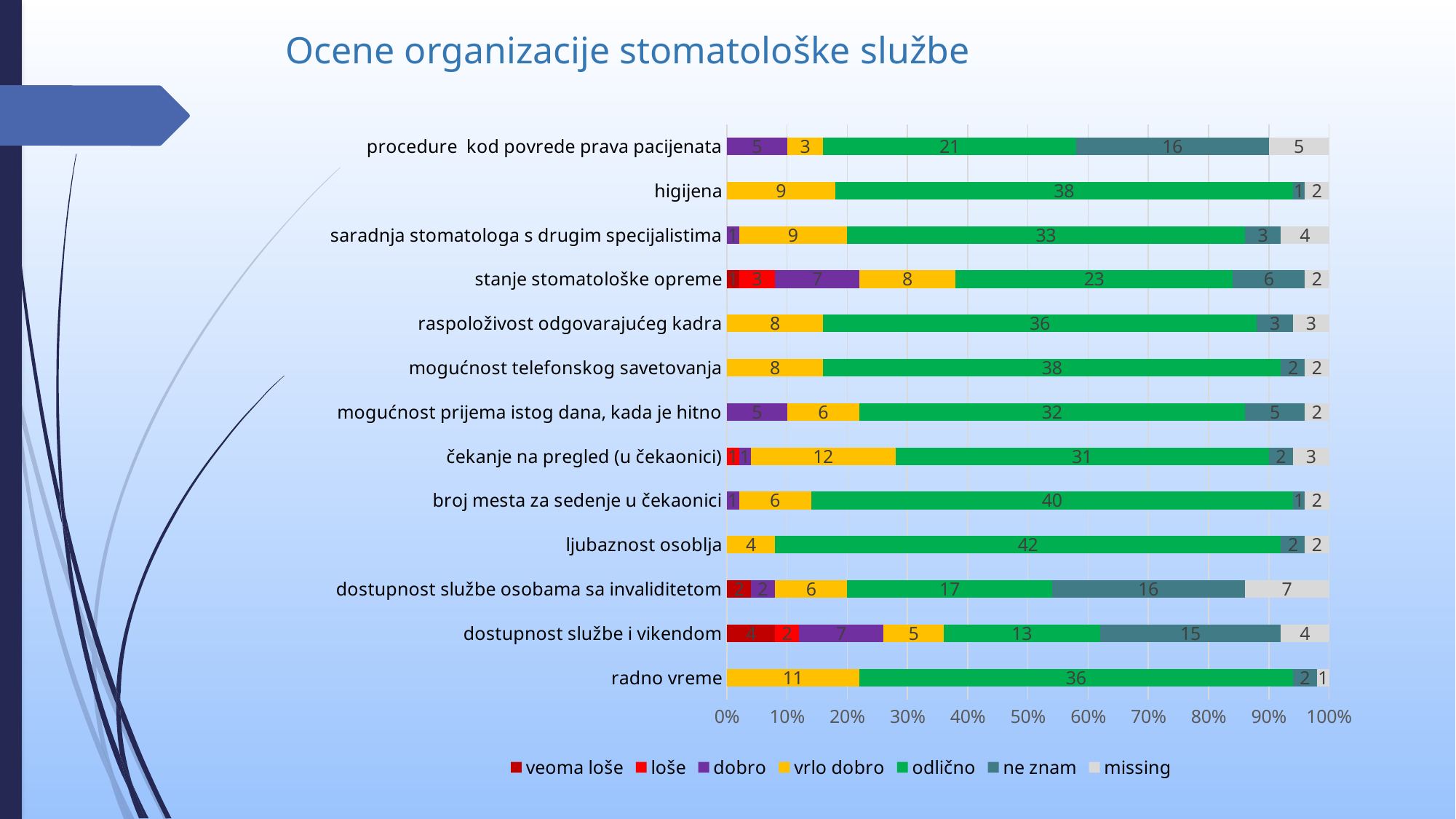
How many series does the legend list? 7 What is the 'ne znam' value for 'dostupnost službe osobama sa invaliditetom'? 16 How many categories are plotted on the chart? 13 What is the 'odlično' value for 'ljubaznost osoblja'? 42 What kind of chart is shown on the slide? stacked bar chart Which is larger: the 'ne znam' value for 'procedure kod povrede prava pacijenata' or for 'dostupnost službe i vikendom'? procedure kod povrede prava pacijenata Which category has the highest 'odlično' value? ljubaznost osoblja What is the 'vrlo dobro' value for 'radno vreme'? 11 Which category has the lowest 'odlično' value? dostupnost službe i vikendom What is the title of the chart? Ocene organizacije stomatološke službe What is the total of all segments in the 'dostupnost službe i vikendom' bar? 50 What is the difference between the 'odlično' values for 'higijena' and 'stanje stomatološke opreme'? 15